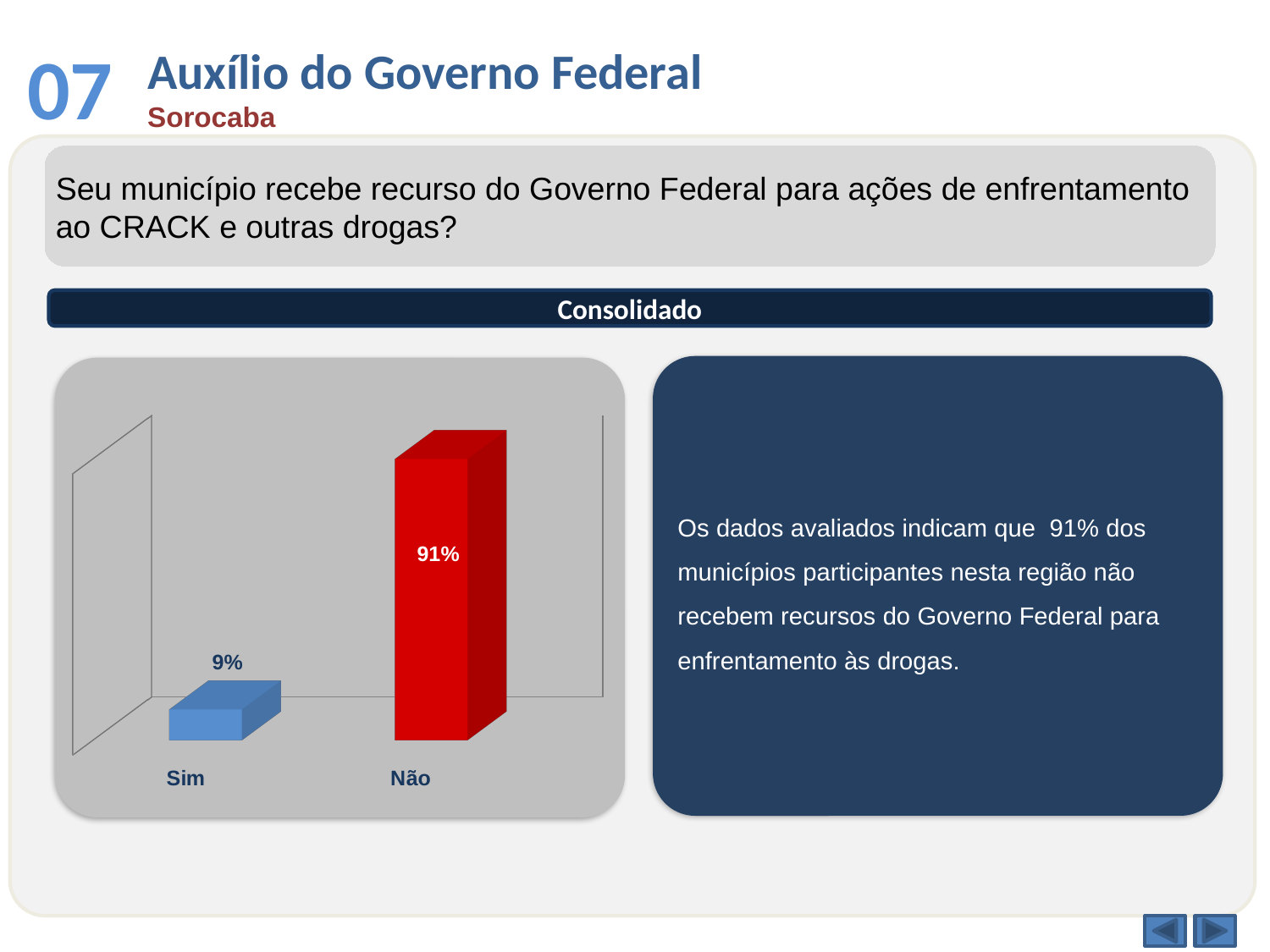
Which is larger, the value for "Sim" or the value for "Não"? Não What is the value for "Sim"? 9% Which category has the lowest value? Sim What is the value for "Não"? 91% What kind of chart is shown on the slide? bar chart What is the total of the values for "Sim" and "Não"? 100% What colour is the bar for "Sim"? blue What colour is the bar for "Não"? red What is the difference between the values for "Não" and "Sim"? 82% Which category has the highest value? Não How many categories are shown in the chart? 2